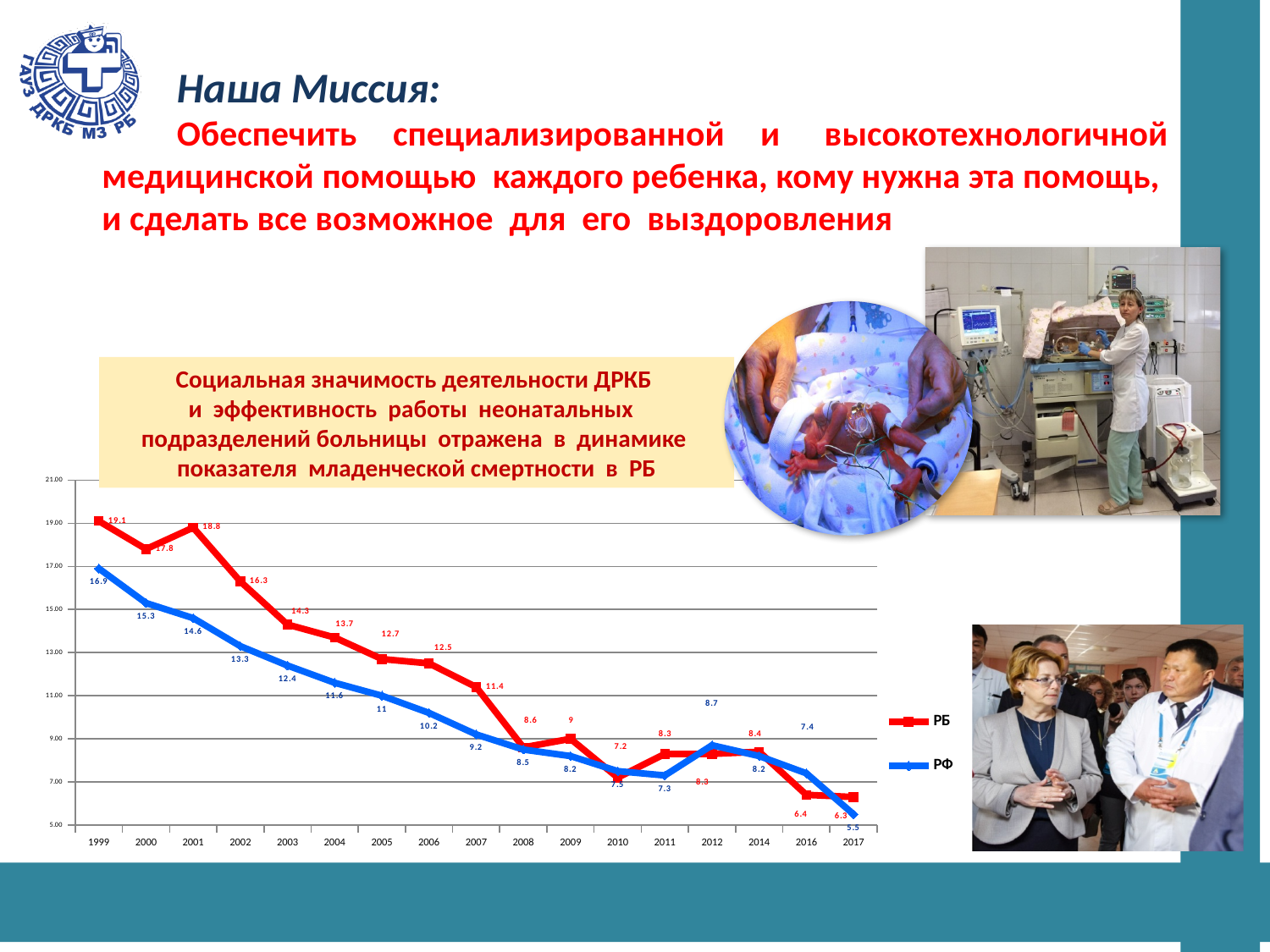
What is the value for РФ in 2017? 5.5 What is the value for РБ in 2007? 11.4 How many series does the chart legend list? 2 In 2005, which series has the larger value, РБ or РФ? РБ In which year is the РФ series at its lowest? 2017 What is the value for РБ in 1999? 19.1 What kind of chart is shown on the slide? line chart In which year is the РБ series at its highest? 1999 How many years are shown on the x axis of the chart? 17 What is the value for РФ in 2003? 12.4 What is the difference between the РБ value in 1999 and the РБ value in 2017? 12.8 Do the values of the РБ series generally rise or fall from 1999 to 2017? fall